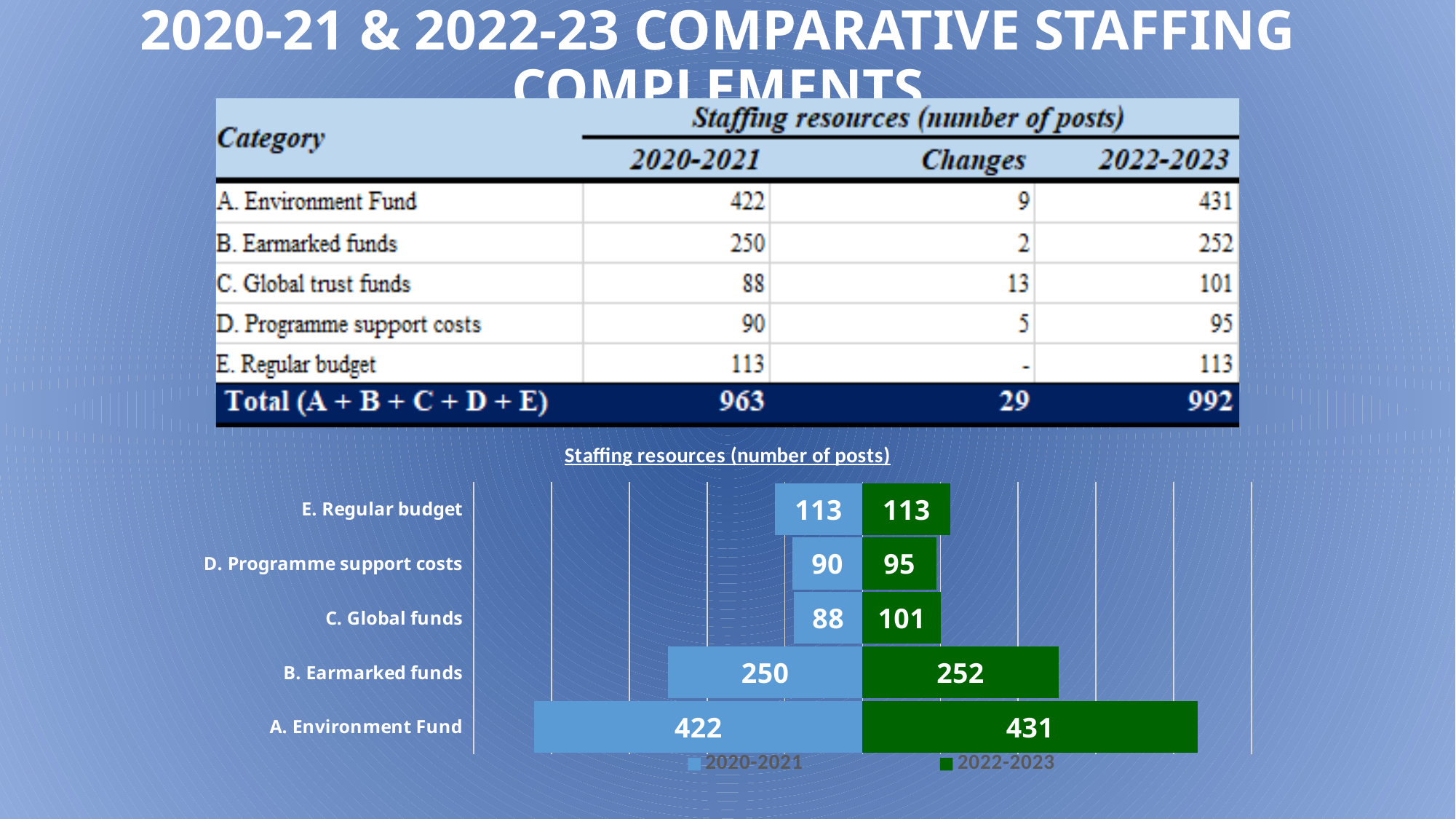
What is the difference between the 2022-2023 and 2020-2021 values for B. Earmarked funds in the chart? 2 What is the 2022-2023 value for C. Global funds in the chart? 101 What is the title of the chart? Staffing resources (number of posts) Which category has the highest 2022-2023 value in the chart? A. Environment Fund What is the 2022-2023 value for D. Programme support costs in the chart? 95 How many series does the chart legend list? 2 What is the 2020-2021 value for A. Environment Fund in the chart? 422 Which category has the lowest 2020-2021 value in the chart? C. Global funds What is the difference between the 2022-2023 and 2020-2021 values for C. Global funds in the chart? 13 Which is larger in the chart: the 2020-2021 value for B. Earmarked funds or the 2020-2021 value for E. Regular budget? B. Earmarked funds What kind of chart is shown on the slide? bar chart How many categories are plotted in the chart? 5